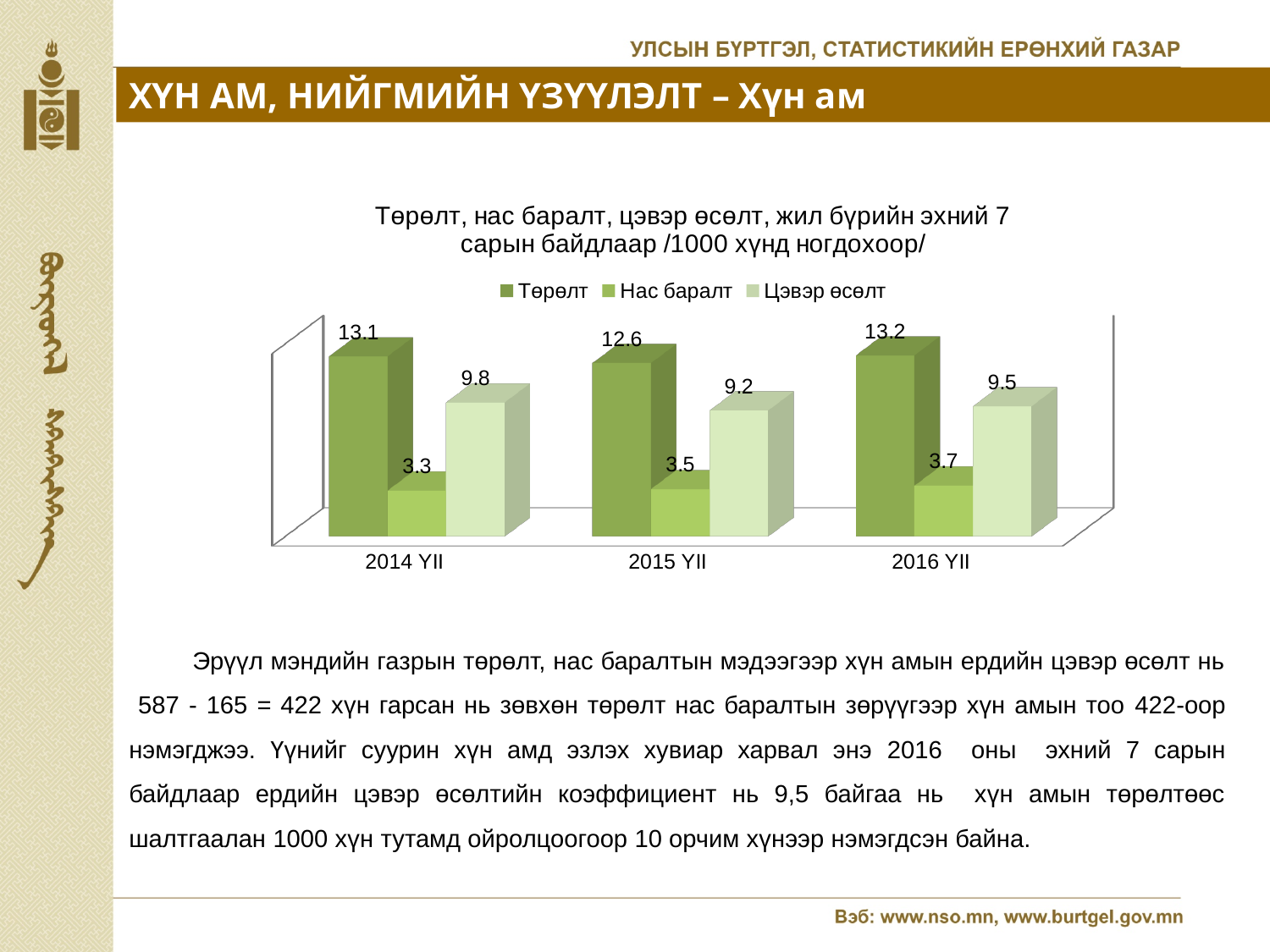
How many years are shown on the x axis? 3 What is the value of Төрөлт for 2014 YII? 13.1 What is the value of Нас баралт for 2015 YII? 3.5 What kind of chart is shown on the slide? Bar chart In which year is Цэвэр өсөлт the lowest? 2015 YII How many series does the legend list? 3 Which is larger for 2014 YII: Цэвэр өсөлт or Нас баралт? Цэвэр өсөлт What is the difference between Төрөлт and Нас баралт for 2016 YII? 9.5 What is the value of Цэвэр өсөлт for 2016 YII? 9.5 What is the first series listed in the chart legend? Төрөлт In which year is Төрөлт the highest? 2016 YII Does Нас баралт rise or fall from 2014 YII to 2016 YII? Rise